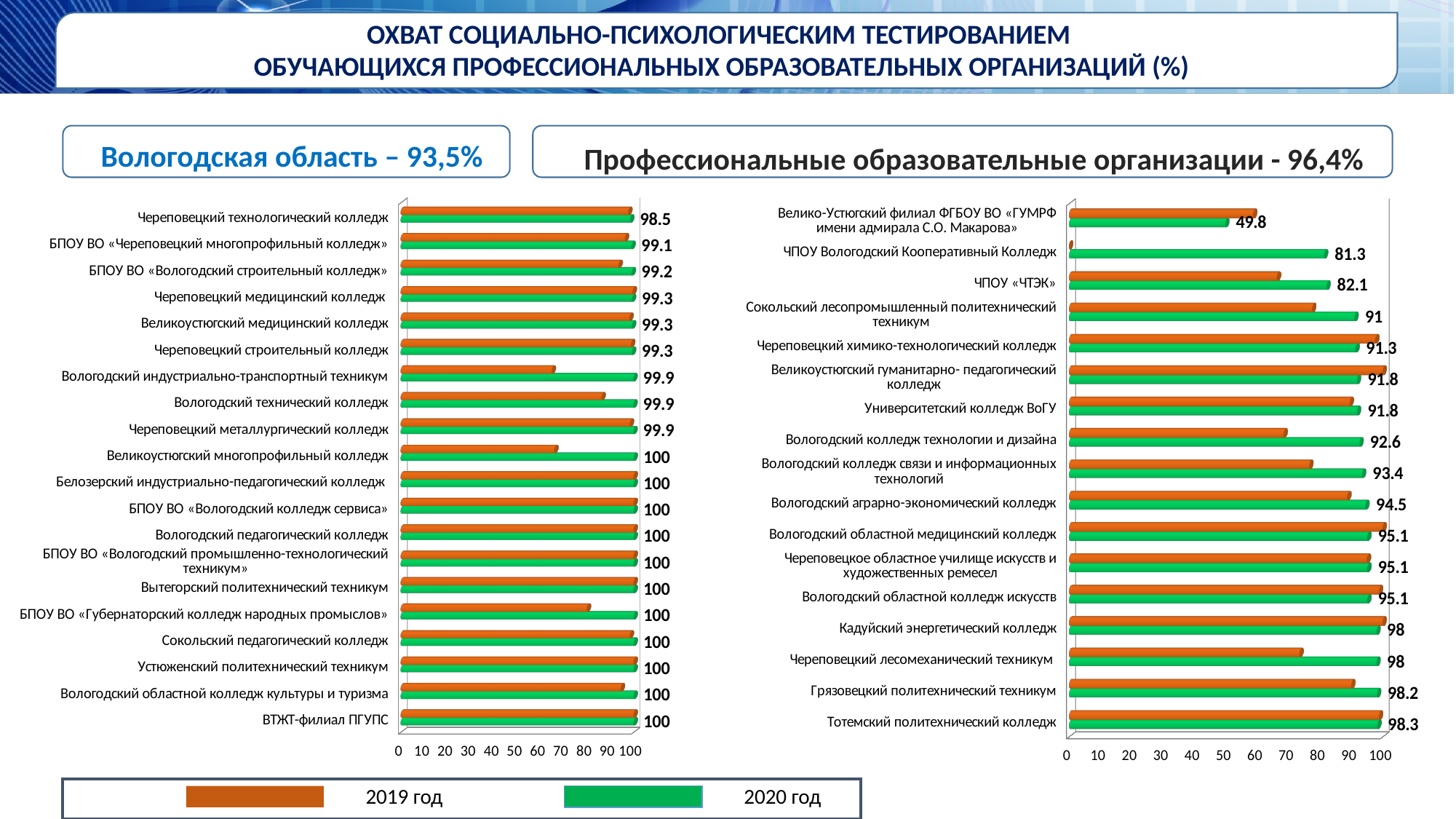
On the right chart, what is the difference between the 2020 values for Тотемский политехнический колледж and Велико-Устюгский филиал ФГБОУ ВО «ГУМРФ имени адмирала С.О. Макарова»? 48.5 On the right chart, which has the larger 2020 value: ЧПОУ «ЧТЭК» or Кадуйский энергетический колледж? Кадуйский энергетический колледж On the left chart, is the 2019 value for Вологодский индустриально-транспортный техникум greater or less than 60? greater What type of chart is used on the slide? Bar chart On the right chart (Профессиональные образовательные организации), what is the 2020 value for Велико-Устюгский филиал ФГБОУ ВО «ГУМРФ имени адмирала С.О. Макарова»? 49.8 How many organisations are listed on the right chart? 17 How many series does the legend list? 2 On the left chart, which organisation has the lowest 2020 value? Череповецкий технологический колледж On the left chart (Вологодская область), what is the 2020 value for Череповецкий технологический колледж? 98.5 On the right chart, which organisation has the lowest 2020 value? Велико-Устюгский филиал ФГБОУ ВО «ГУМРФ имени адмирала С.О. Макарова» On the right chart, what is the 2020 value for Вологодский колледж связи и информационных технологий? 93.4 On the right chart, is the 2019 value for ЧПОУ Вологодский Кооперативный Колледж greater or less than 10? less